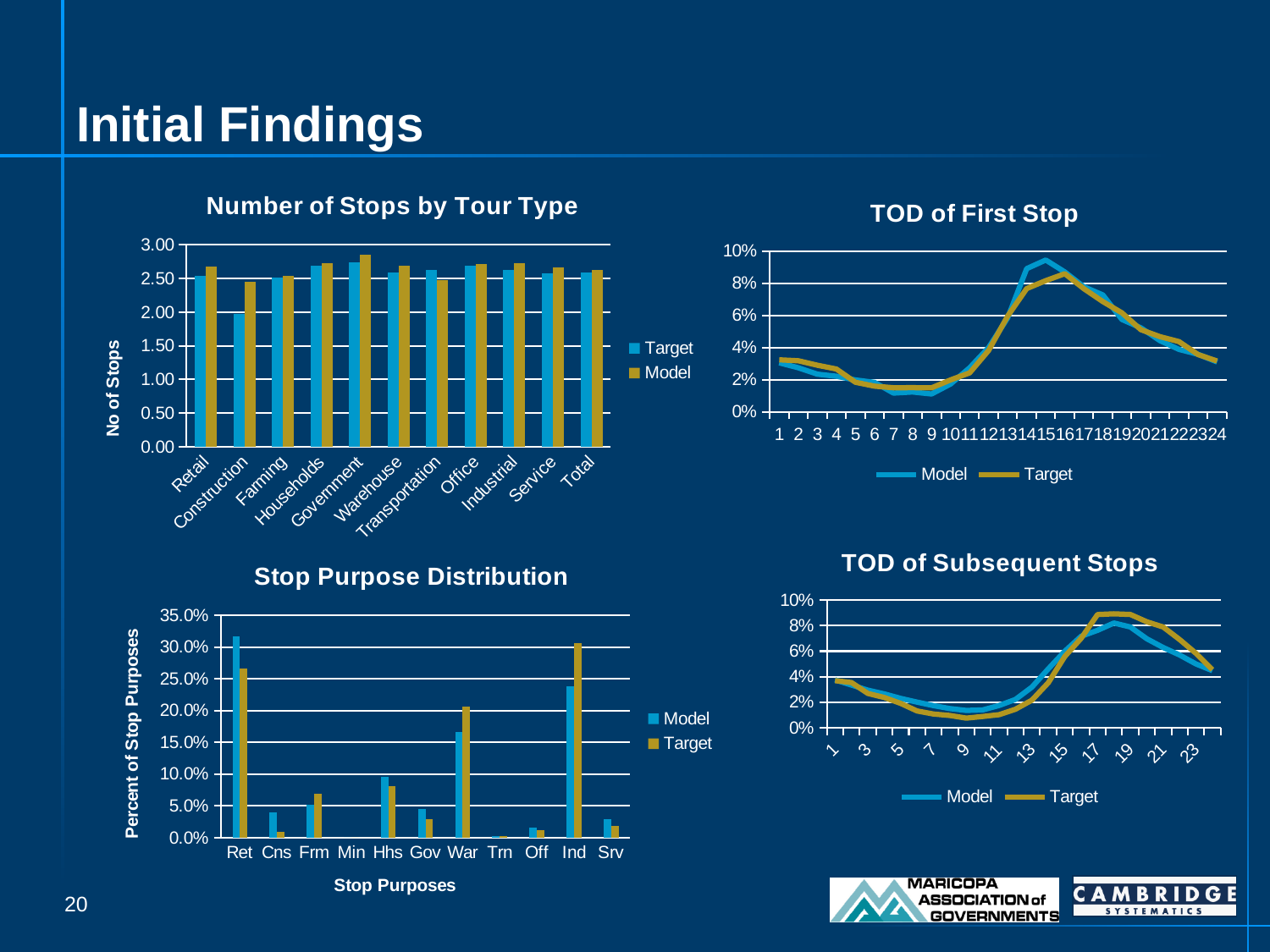
In the "Number of Stops by Tour Type" chart, which category has the lowest Target value? Construction In the "Stop Purpose Distribution" chart, which is larger for Ret, the Model value or the Target value? Model In the "TOD of First Stop" chart, is the Model value at hour 15 greater or less than 8%? greater In the "Number of Stops by Tour Type" chart, how many tour type categories are shown on the x axis? 11 In the "Number of Stops by Tour Type" chart, which category has the highest Model value? Government What kind of chart is the "TOD of First Stop" chart? line chart In the "Stop Purpose Distribution" chart, is the Model value for Ret greater or less than 30.0%? greater In the "TOD of Subsequent Stops" chart, is the Target value at hour 17 greater or less than 8%? greater What kind of chart is the "Number of Stops by Tour Type" chart? bar chart In the "TOD of First Stop" chart, how many series does the legend list? 2